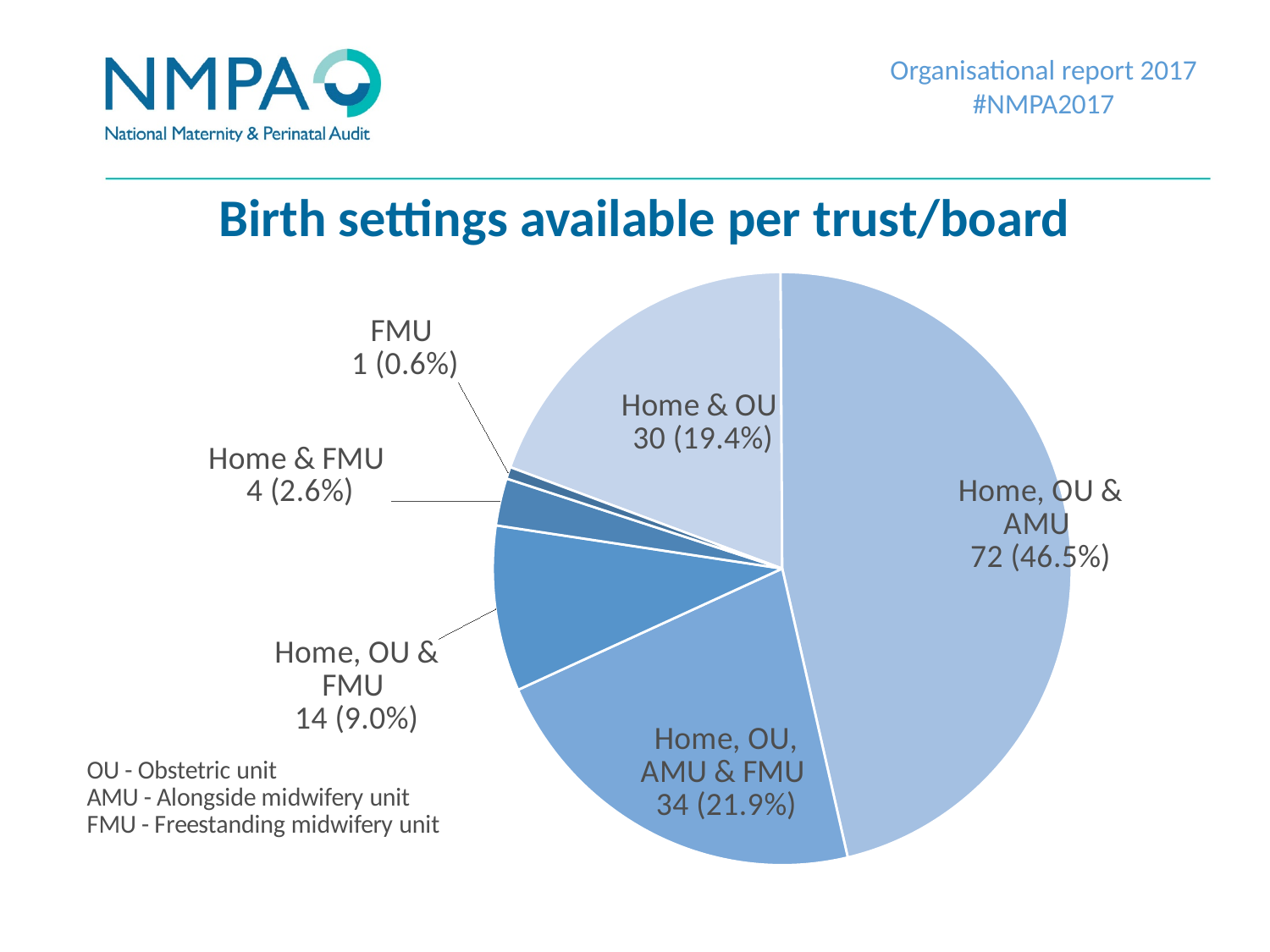
Which is larger: the number of trusts/boards offering Home & OU or Home, OU & FMU? Home & OU How many trusts/boards offer Home, OU & AMU? 72 What is the title of the chart? Birth settings available per trust/board Which birth setting combination is available in the fewest trusts/boards? FMU What percentage of trusts/boards offer Home & OU? 19.4% How many slices does the pie chart have? 6 What share of the pie does the Home & FMU slice represent? 2.6% How many trusts/boards offer Home, OU, AMU & FMU? 34 Which birth setting combination is available in the most trusts/boards? Home, OU & AMU What kind of chart is shown on the slide? pie chart What is the difference between the number of trusts/boards offering Home, OU & AMU and those offering Home, OU, AMU & FMU? 38 What percentage of trusts/boards offer Home, OU & FMU? 9.0%